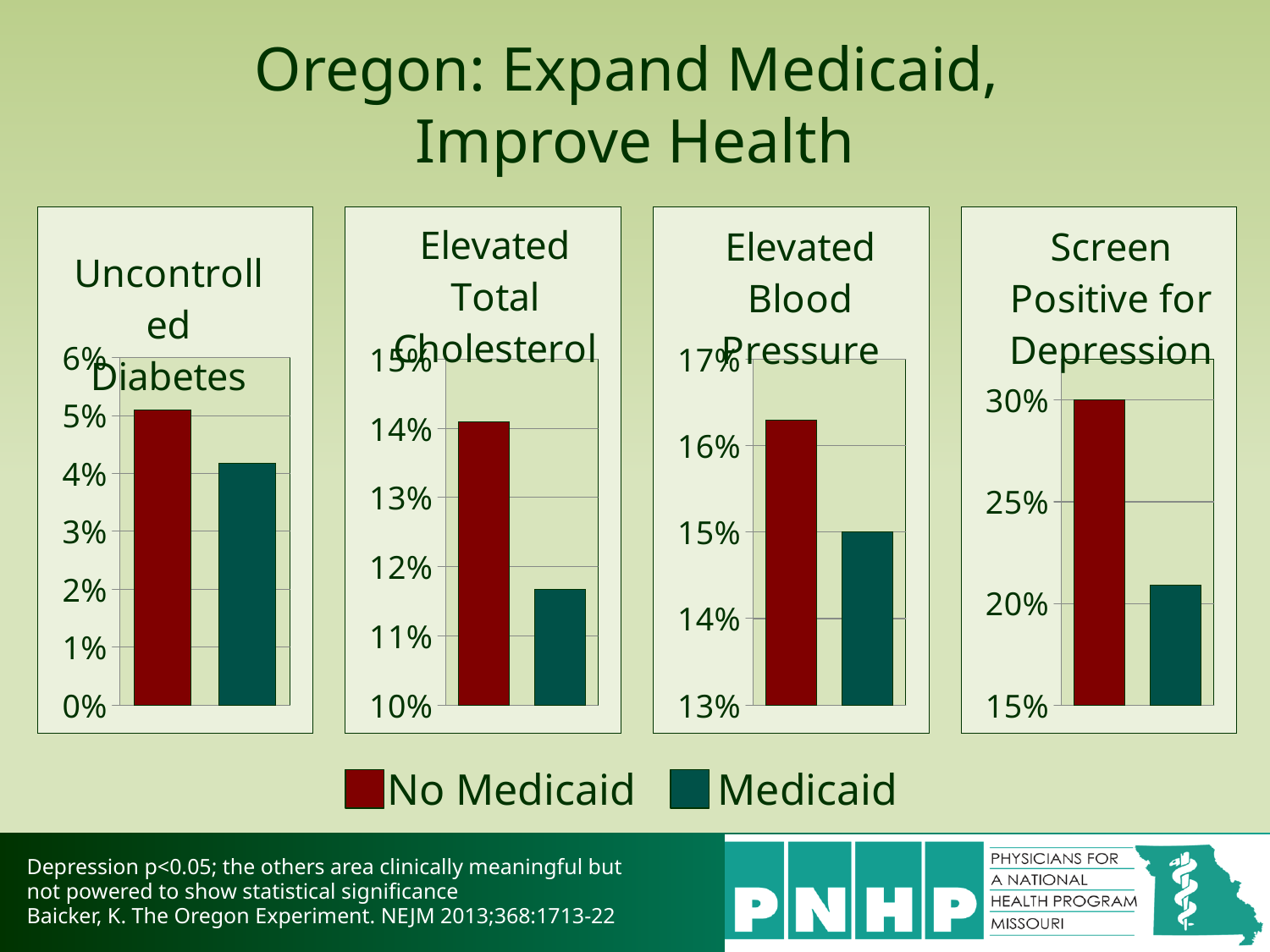
In the Uncontrolled Diabetes chart, which group has the larger value, No Medicaid or Medicaid? No Medicaid In the Uncontrolled Diabetes chart, is the value for No Medicaid greater or less than 4%? greater In the Screen Positive for Depression chart, is the value for Medicaid greater or less than 25%? less In the Elevated Total Cholesterol chart, is the value for No Medicaid greater or less than 13%? greater How many separate bar charts are shown on the slide? 4 What kind of chart is used in the Uncontrolled Diabetes panel? bar chart What are the two entries in the legend? No Medicaid, Medicaid In the Elevated Blood Pressure chart, which group has the larger value, No Medicaid or Medicaid? No Medicaid How many series does the legend list? 2